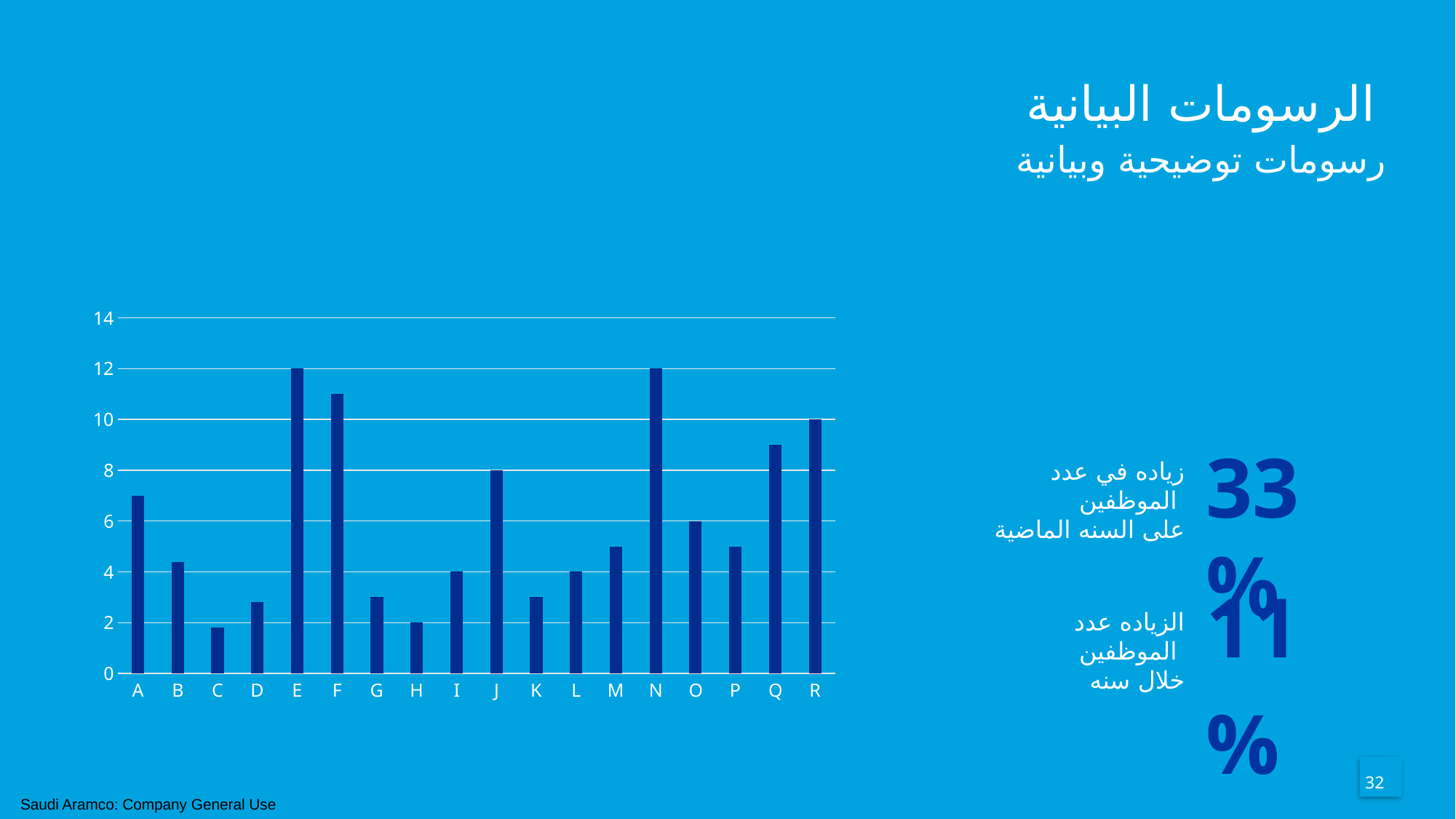
Is the value for F greater or less than 10? greater What is the value for category H? 2 What is the value for category R? 10 What type of chart is shown on the slide? bar chart What is the difference between the values for E and H? 10 What colour are the bars in the chart? dark blue Is the value for Q greater or less than 8? greater Is the value for D greater or less than 4? less What is the value for category J? 8 What is the value for category E? 12 Which is larger, the value for E or the value for A? E How many categories are plotted on the x axis of the bar chart? 18